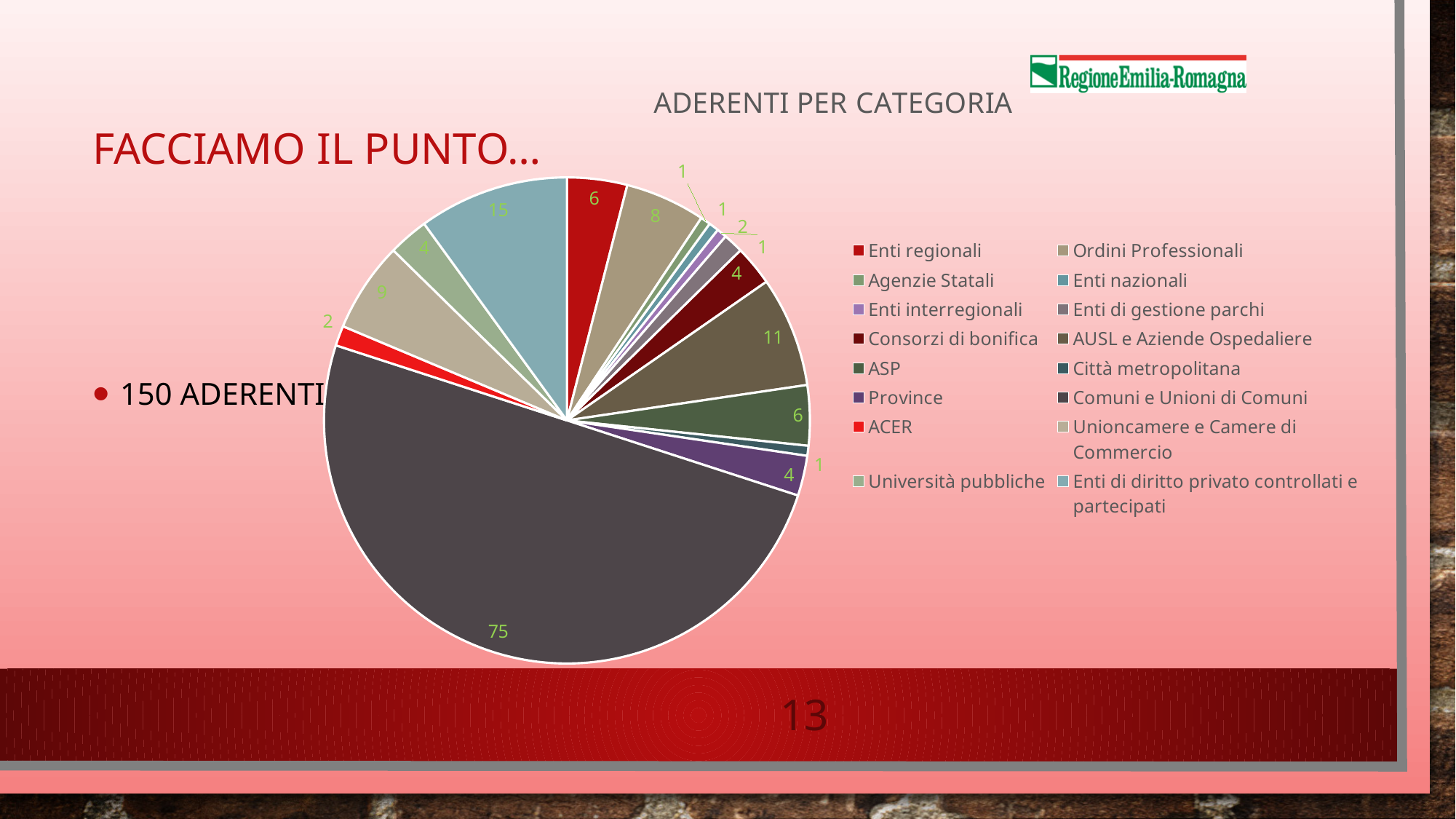
Which is larger, the value for Ordini Professionali or the value for Enti regionali? Ordini Professionali What is the value for Comuni e Unioni di Comuni? 75 What is the value for Unioncamere e Camere di Commercio? 9 What is the total of all slices in the pie? 150 What kind of chart is shown on the slide? pie chart What is the value for Enti di diritto privato controllati e partecipati? 15 Which category has the largest slice? Comuni e Unioni di Comuni What is the value for AUSL e Aziende Ospedaliere? 11 What share of the pie does Comuni e Unioni di Comuni represent? 50% How many categories does the chart's legend list? 16 What is the difference between the values for Comuni e Unioni di Comuni and Enti di diritto privato controllati e partecipati? 60 What is the title of the chart? ADERENTI PER CATEGORIA